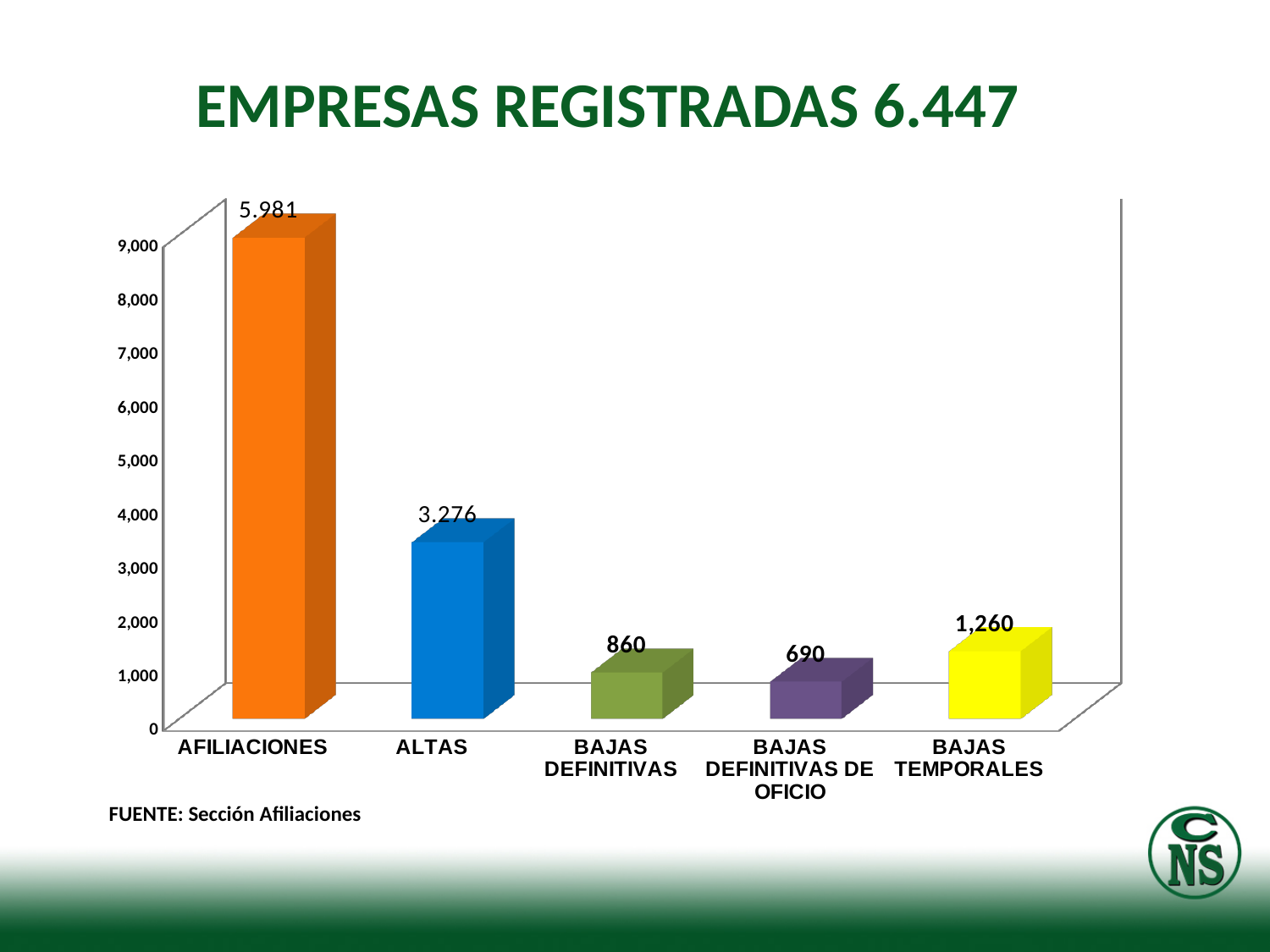
What type of chart is shown on the slide? Bar chart Which category has the highest value? AFILIACIONES How many categories are shown on the chart? 5 What is the difference between the values for BAJAS TEMPORALES and BAJAS DEFINITIVAS? 400 What is the value shown for BAJAS TEMPORALES? 1,260 Which is larger, the value for BAJAS TEMPORALES or the value for BAJAS DEFINITIVAS? BAJAS TEMPORALES What is the value shown for BAJAS DEFINITIVAS DE OFICIO? 690 Which category has the lowest value? BAJAS DEFINITIVAS DE OFICIO What is the value shown for AFILIACIONES? 5.981 What is the value shown for BAJAS DEFINITIVAS? 860 What is the value shown for ALTAS? 3.276 What is the difference between the values for BAJAS DEFINITIVAS and BAJAS DEFINITIVAS DE OFICIO? 170